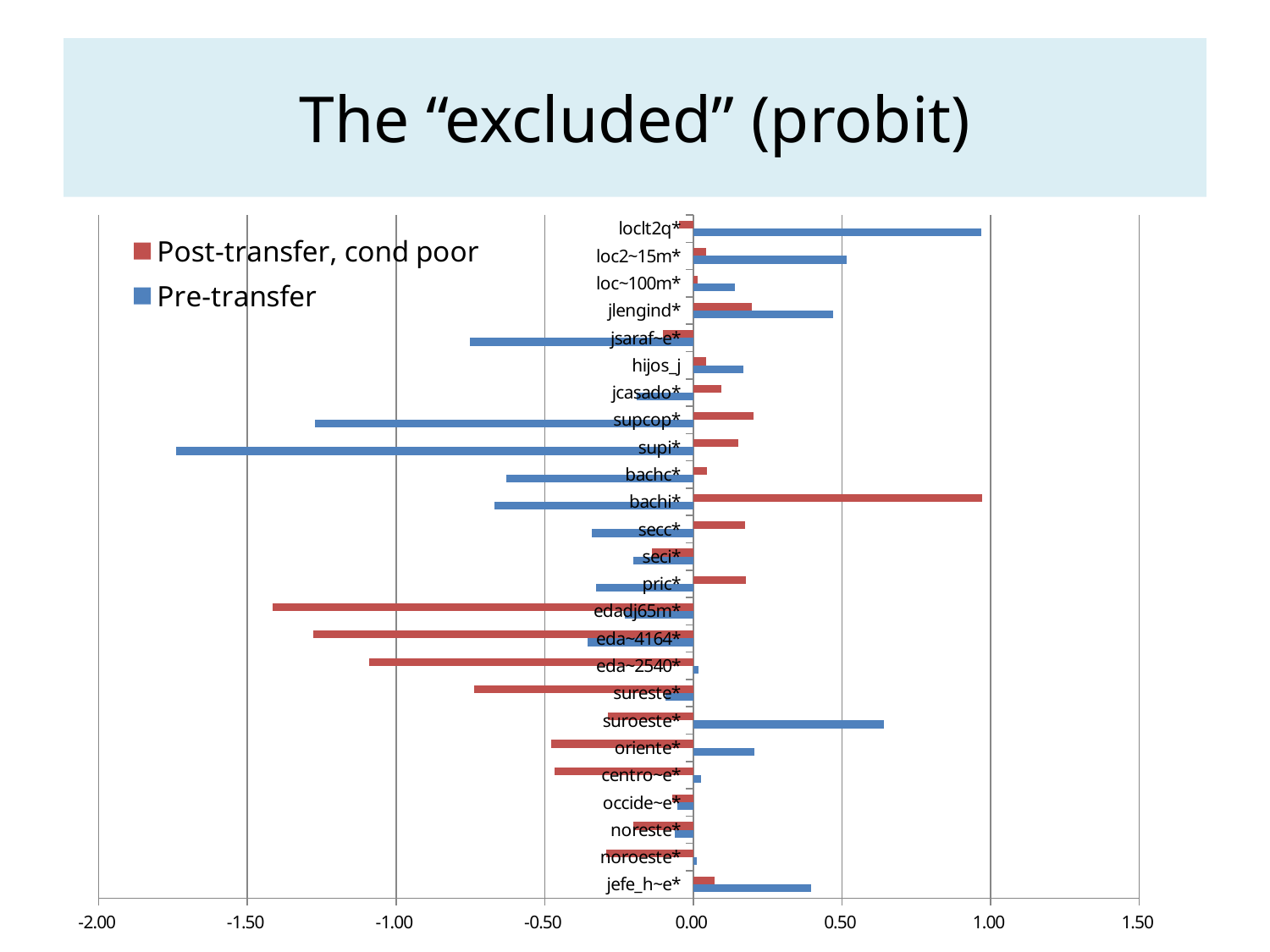
Is the Post-transfer, cond poor value for bachi* greater or less than 0.50? greater Is the Pre-transfer value for supi* greater or less than -1.50? less Is the Pre-transfer value for supcop* greater or less than -1.00? less How many series does the legend list? 2 Which is larger, the Pre-transfer value for loclt2q* or the Pre-transfer value for loc2~15m*? loclt2q* What kind of chart is shown on the slide? Bar chart Which colour represents the Pre-transfer series? Blue How many categories are plotted on the chart? 25 Which category has the highest Post-transfer, cond poor value? bachi* Which category has the lowest Pre-transfer value? supi*